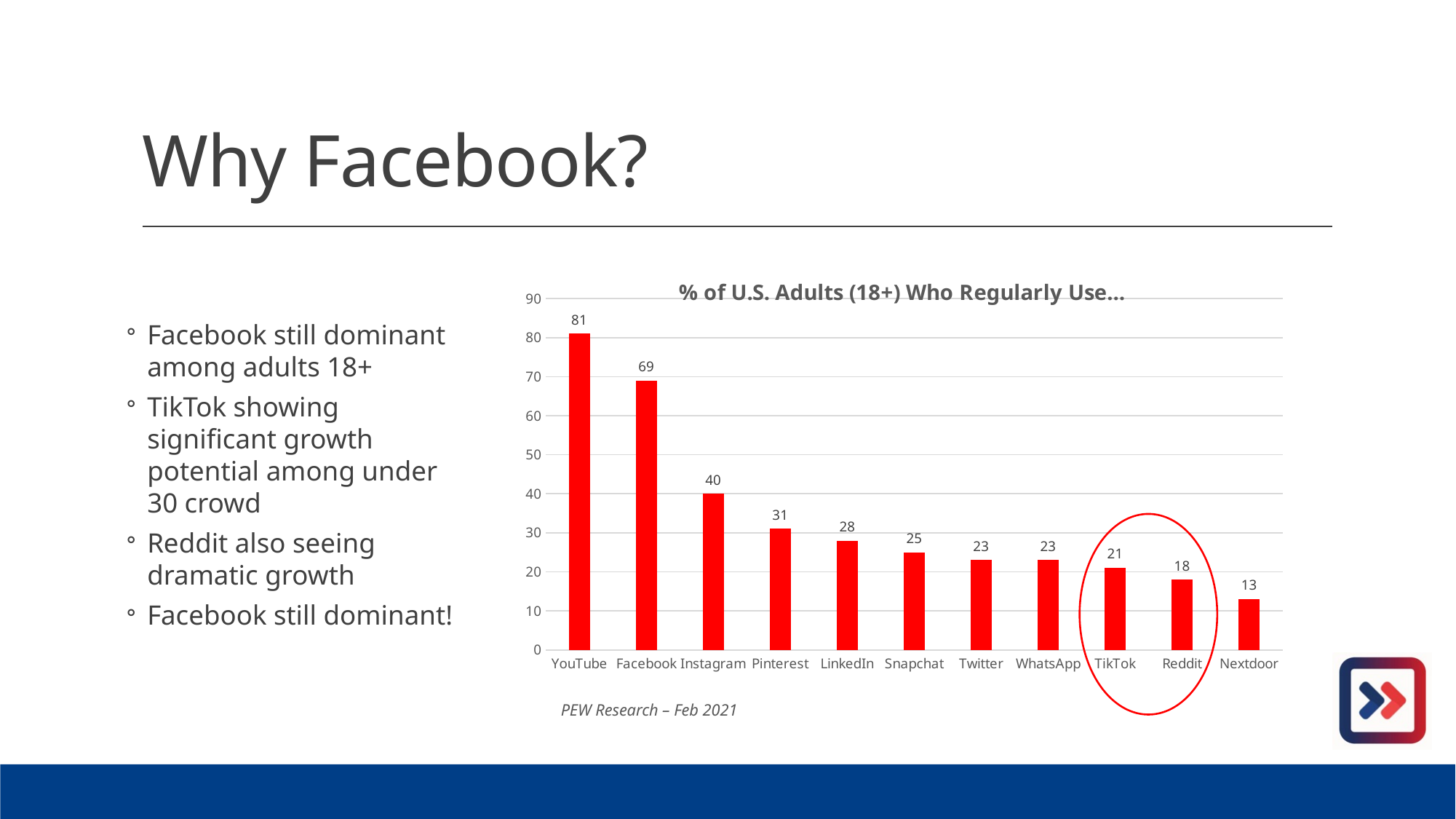
What is the title of the chart? % of U.S. Adults (18+) Who Regularly Use... Do the values rise or fall from left to right along the x axis? fall What is the value for Facebook? 69 What is the difference between the values for YouTube and Facebook? 12 What is the value for YouTube? 81 How many platforms are shown on the x axis? 11 What is the value for TikTok? 21 Is the value for LinkedIn greater or less than 30? less What kind of chart is shown on the slide? bar chart Which platform has the lowest value? Nextdoor Which is larger, the value for Instagram or the value for Pinterest? Instagram Which platform has the highest value? YouTube